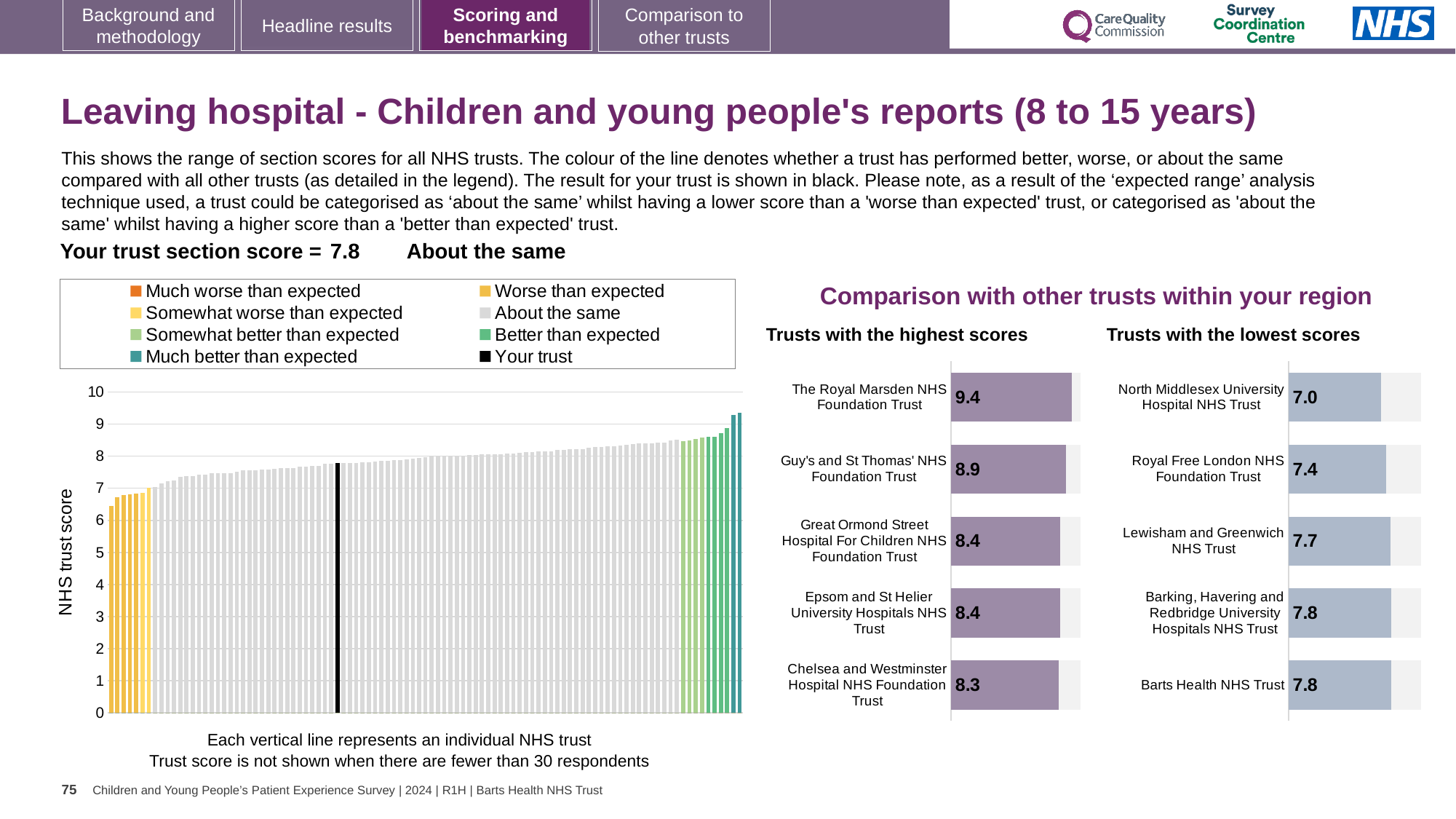
In the large chart on the left, is the value of the tallest bar greater or less than 9? greater In the 'Trusts with the lowest scores' chart, which trust has the lowest score? North Middlesex University Hospital NHS Trust How many entries does the legend of the large chart on the left list? 8 In the 'Trusts with the highest scores' chart, what is the difference between the scores of The Royal Marsden NHS Foundation Trust and Chelsea and Westminster Hospital NHS Foundation Trust? 1.1 In the 'Trusts with the highest scores' chart, which trust has the highest score? The Royal Marsden NHS Foundation Trust How many trusts are shown in the 'Trusts with the highest scores' chart? 5 In the 'Trusts with the lowest scores' chart, what is the score for North Middlesex University Hospital NHS Trust? 7.0 In the 'Trusts with the lowest scores' chart, which has the larger score: Royal Free London NHS Foundation Trust or Lewisham and Greenwich NHS Trust? Lewisham and Greenwich NHS Trust In the 'Trusts with the highest scores' chart, what is the score for The Royal Marsden NHS Foundation Trust? 9.4 In the 'Trusts with the lowest scores' chart, what is the score for Barts Health NHS Trust? 7.8 In the large chart on the left, do the bar values rise or fall from left to right? rise In the 'Trusts with the highest scores' chart, what is the score for Guy's and St Thomas' NHS Foundation Trust? 8.9